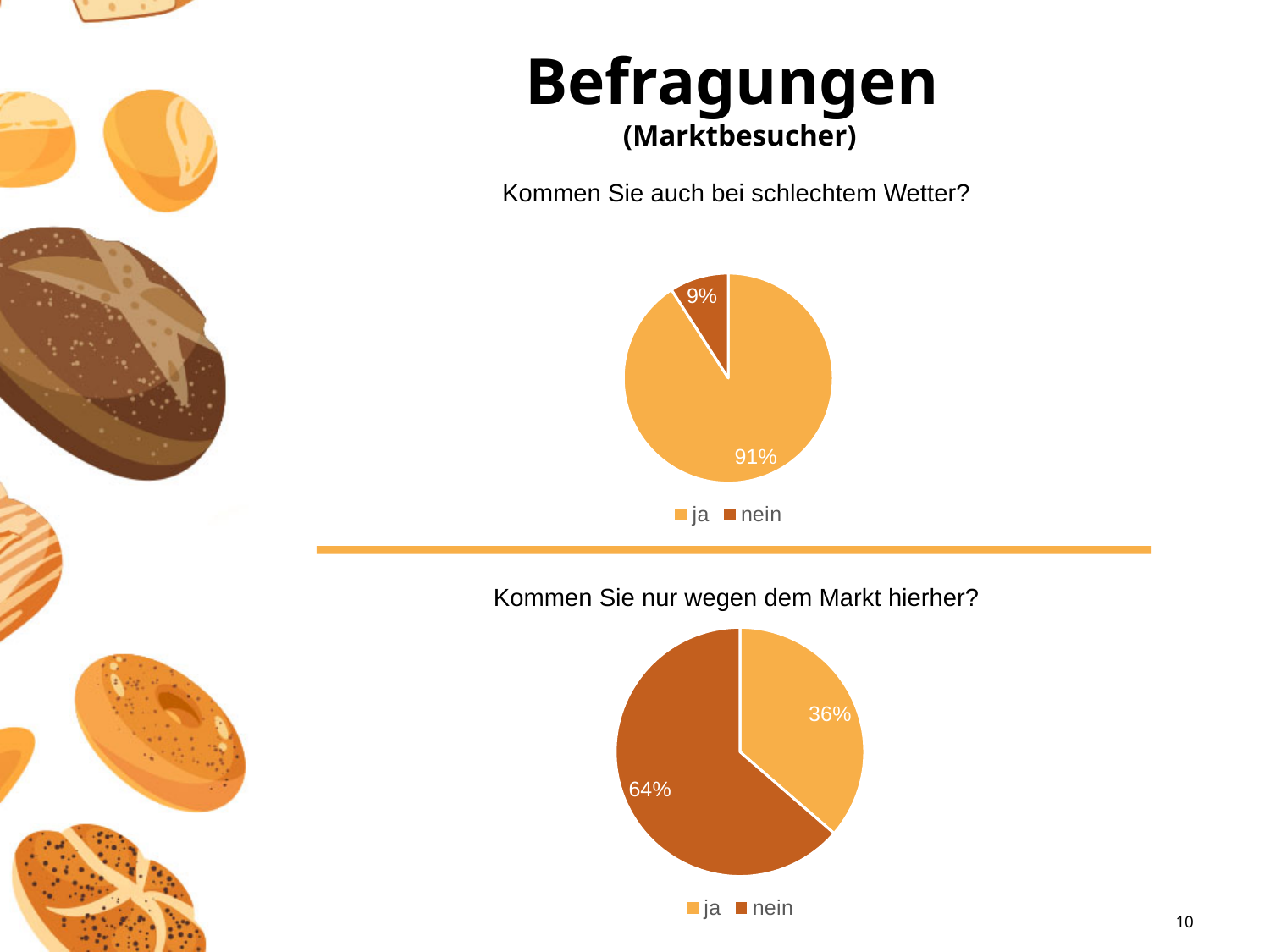
In the chart 'Kommen Sie nur wegen dem Markt hierher?', what share of respondents answered 'ja'? 36% In the chart 'Kommen Sie auch bei schlechtem Wetter?', what share of respondents answered 'nein'? 9% In the chart 'Kommen Sie nur wegen dem Markt hierher?', which answer has the smallest slice? ja In the chart 'Kommen Sie nur wegen dem Markt hierher?', what is the difference in percentage points between 'nein' and 'ja'? 28 In the chart 'Kommen Sie auch bei schlechtem Wetter?', what share of respondents answered 'ja'? 91% In the chart 'Kommen Sie auch bei schlechtem Wetter?', which answer has the largest slice? ja In the chart 'Kommen Sie nur wegen dem Markt hierher?', what share of respondents answered 'nein'? 64% How many slices does the chart 'Kommen Sie nur wegen dem Markt hierher?' have? 2 What type of chart is used for 'Kommen Sie auch bei schlechtem Wetter?'? pie chart In the chart 'Kommen Sie auch bei schlechtem Wetter?', what is the difference in percentage points between 'ja' and 'nein'? 82 In the chart 'Kommen Sie nur wegen dem Markt hierher?', which is larger, 'ja' or 'nein'? nein What entries does the legend of the chart 'Kommen Sie auch bei schlechtem Wetter?' list? ja, nein